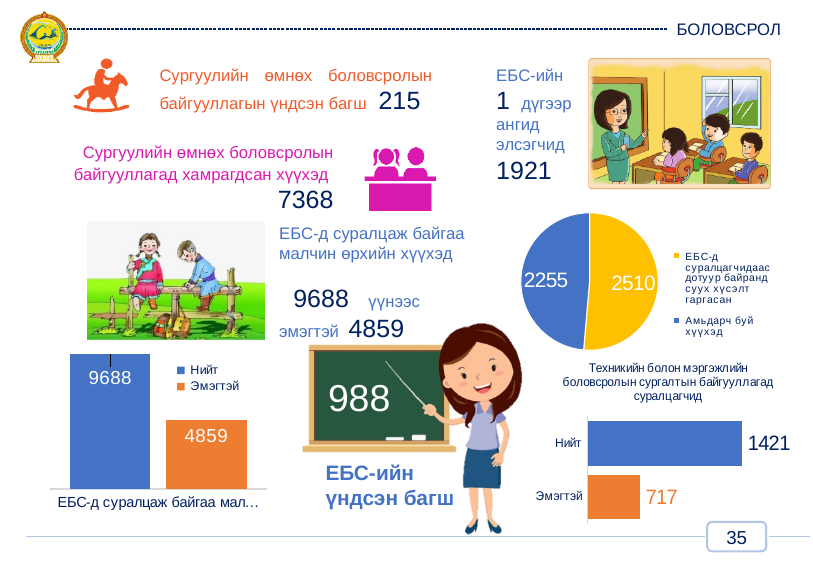
In the bottom-left bar chart, how many series does the legend list? 2 What kind of chart is the bottom-left chart? bar chart In the pie chart on the right, what is the value of the yellow slice labelled 'ЕБС-д суралцагчидаас дотуур байранд суух хүсэлт гаргасан'? 2510 In the bottom-left bar chart, what is the value for Нийт? 9688 In the bottom-left bar chart, what is the value for Эмэгтэй? 4859 In the chart titled 'Техникийн болон мэргэжлийн боловсролын сургалтын байгууллагад суралцагчид', what is the value for Нийт? 1421 In the pie chart on the right, which slice is larger: 'ЕБС-д суралцагчидаас дотуур байранд суух хүсэлт гаргасан' or 'Амьдарч буй хүүхэд'? ЕБС-д суралцагчидаас дотуур байранд суух хүсэлт гаргасан In the pie chart on the right, what is the value of the blue slice labelled 'Амьдарч буй хүүхэд'? 2255 In the chart titled 'Техникийн болон мэргэжлийн боловсролын сургалтын байгууллагад суралцагчид', what is the difference between Нийт and Эмэгтэй? 704 In the chart titled 'Техникийн болон мэргэжлийн боловсролын сургалтын байгууллагад суралцагчид', what is the value for Эмэгтэй? 717 How many slices does the pie chart on the right have? 2 In the bottom-left bar chart, what is the difference between the Нийт and Эмэгтэй values? 4829